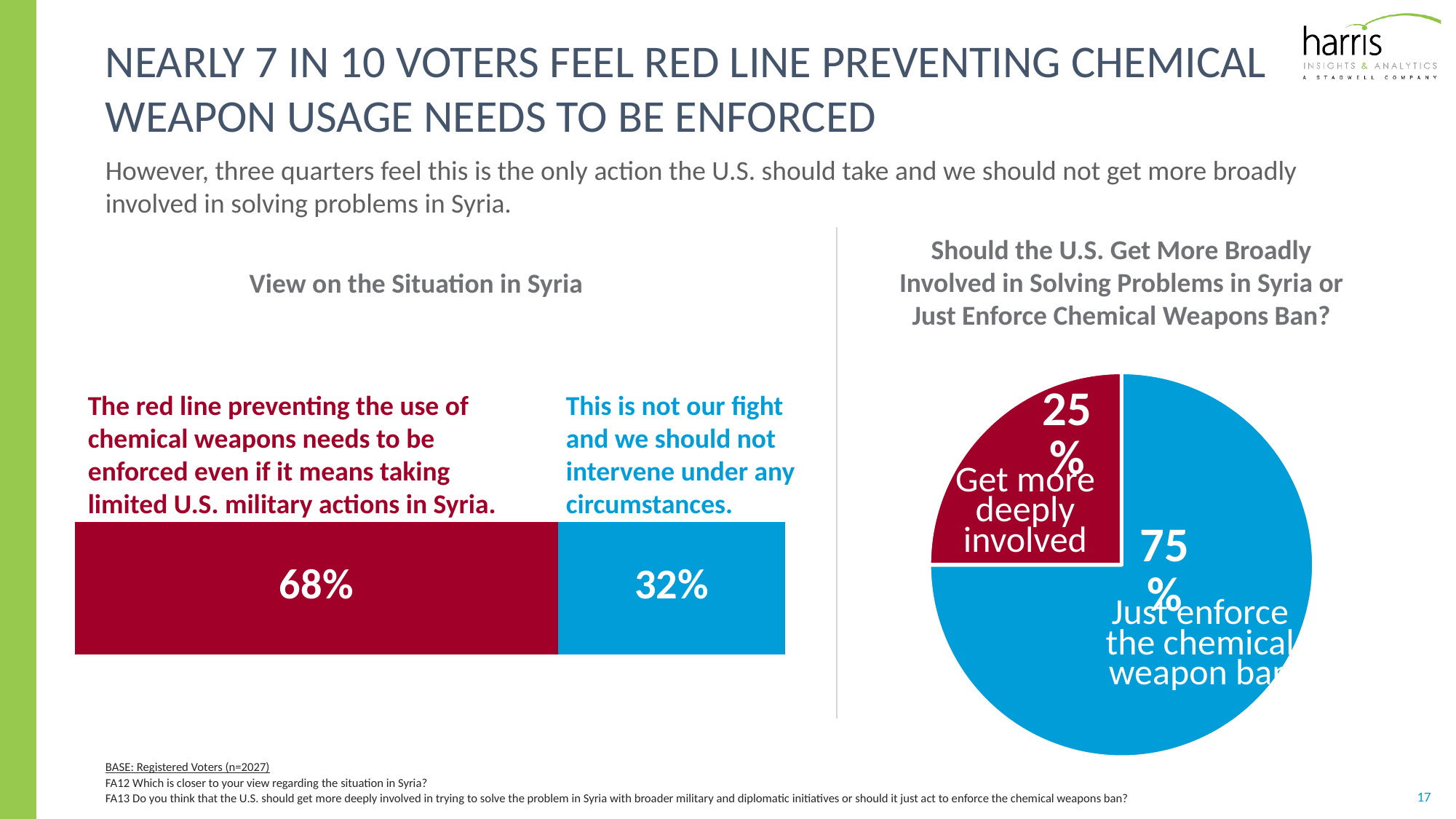
In the 'View on the Situation in Syria' chart, what percentage of voters say this is not our fight and we should not intervene under any circumstances? 32% In the 'View on the Situation in Syria' chart, what percentage of voters say the red line preventing the use of chemical weapons needs to be enforced even if it means taking limited U.S. military actions in Syria? 68% In the 'View on the Situation in Syria' chart, what is the total of the two segments of the bar? 100% In the pie chart on the right, which option has the smallest share? Get more deeply involved What kind of chart is shown on the right side of the slide? Pie chart In the pie chart on the right, what percentage of voters say the U.S. should get more deeply involved? 25% In the 'View on the Situation in Syria' chart, what is the difference in percentage points between the two views? 36 percentage points In the 'View on the Situation in Syria' chart, which view has the larger share of voters? The red line preventing the use of chemical weapons needs to be enforced even if it means taking limited U.S. military actions in Syria. What kind of chart is 'View on the Situation in Syria'? Bar chart In the pie chart on the right, how many slices are there? 2 In the pie chart on the right, what percentage of voters say the U.S. should just enforce the chemical weapon ban? 75% In the 'View on the Situation in Syria' chart, what colour is the segment for 'This is not our fight and we should not intervene under any circumstances'? Blue